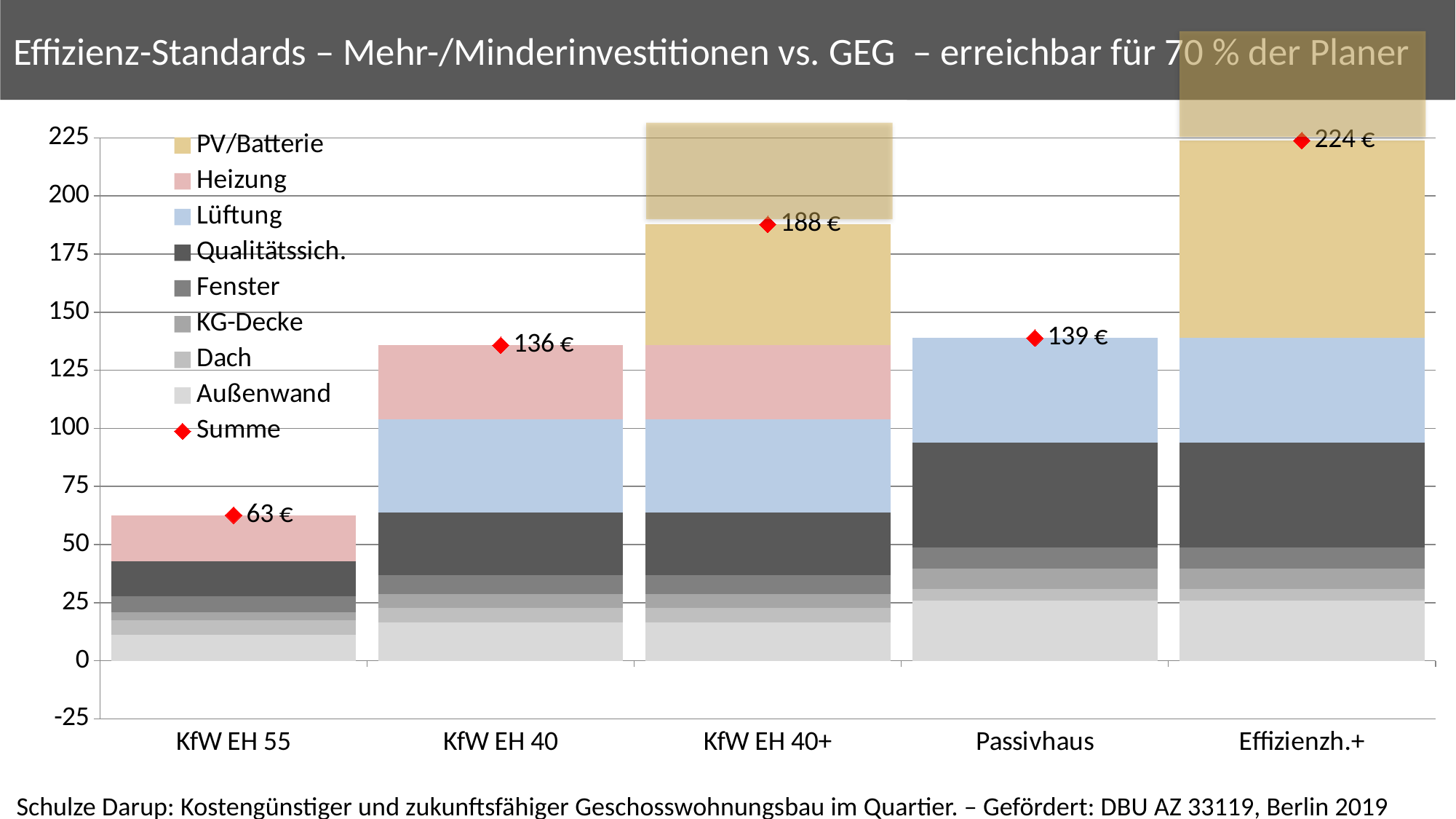
How many entries does the legend list? 9 Which category has the lowest Summe value? KfW EH 55 Is the Summe value for KfW EH 40 greater or less than 125? greater What is the difference between the Summe values for Effizienzh.+ and KfW EH 40+? 36 € What is the Summe value for KfW EH 40+? 188 € Which category has the highest Summe value? Effizienzh.+ What kind of chart is shown on the slide? Stacked bar chart What is the difference between the Summe values for KfW EH 40 and KfW EH 55? 73 € How many categories are shown on the x axis? 5 What is the Summe value for KfW EH 55? 63 € What is the Summe value for Passivhaus? 139 € Which has a larger Summe value, KfW EH 40+ or Passivhaus? KfW EH 40+